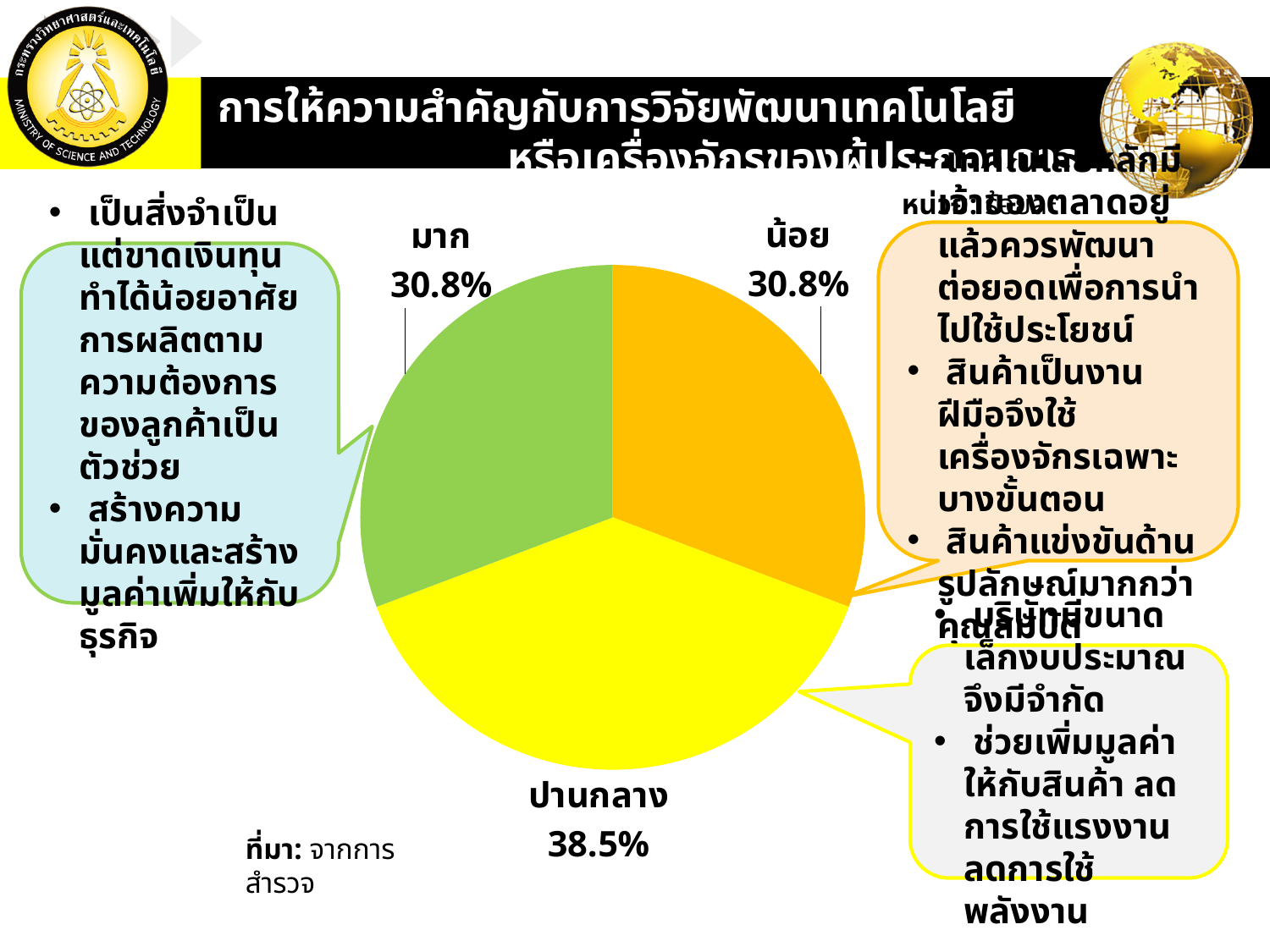
What percentage is shown for the น้อย slice? 30.8% What percentage is shown for the มาก slice? 30.8% What colour is the ปานกลาง slice of the pie chart? yellow What colour is the มาก slice of the pie chart? green Which slice of the pie chart is the largest? ปานกลาง Which is larger, the ปานกลาง slice or the มาก slice? ปานกลาง What share of the pie does the ปานกลาง slice represent? 38.5% Do the มาก and น้อย slices have the same percentage? Yes What percentage is shown for the ปานกลาง slice? 38.5% How many slices does the pie chart have? 3 What kind of chart is shown on the slide? pie chart What is the difference in percentage points between the ปานกลาง slice and the น้อย slice? 7.7